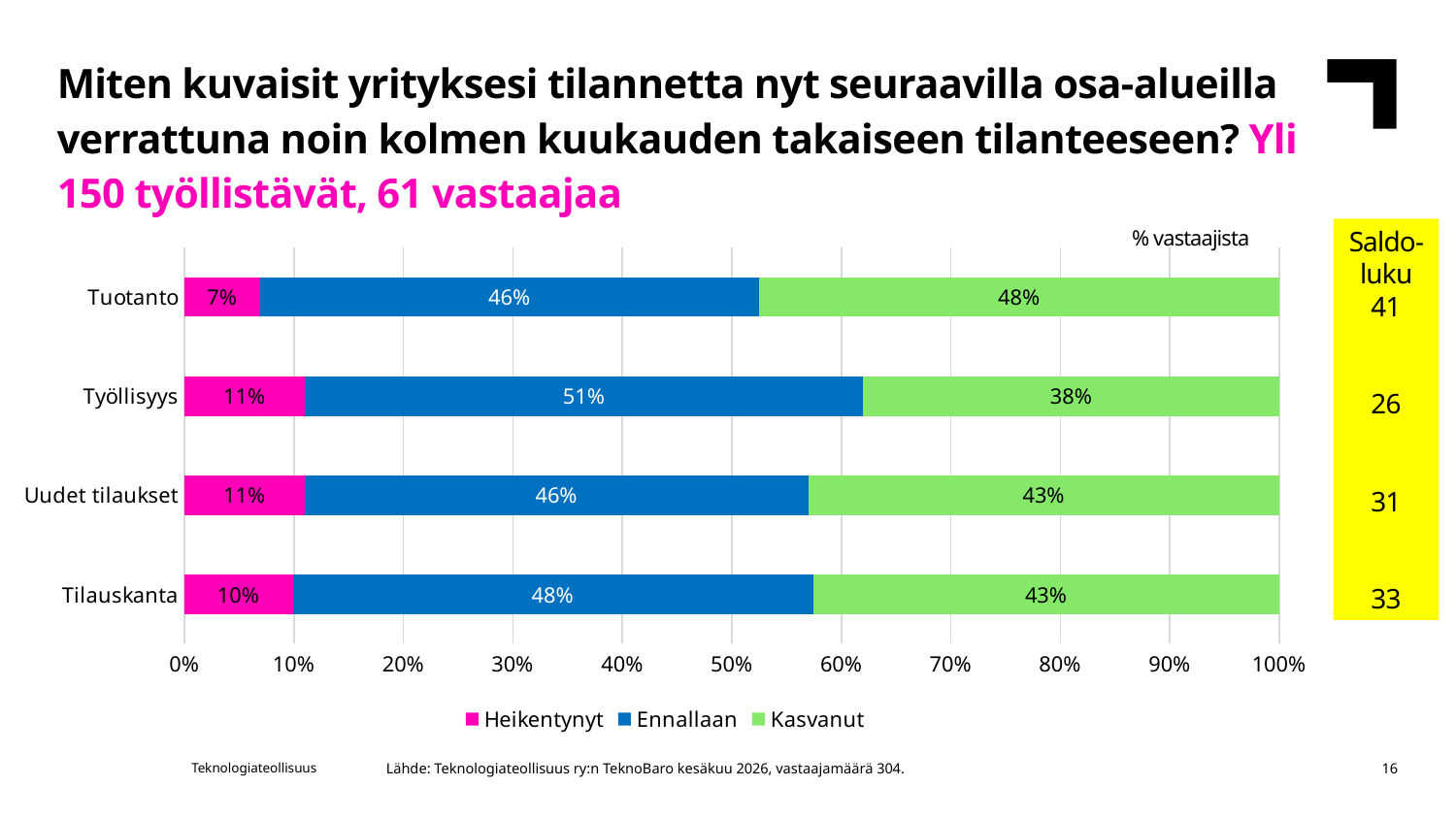
Which category has the highest "Kasvanut" share? Tuotanto How many categories are shown on the y axis of the chart? 4 What percentage of respondents answered "Kasvanut" for Tuotanto? 48% What is the "Ennallaan" value for Työllisyys? 51% Which category has the lowest "Heikentynyt" share? Tuotanto How many series does the legend list? 3 Which colour represents the "Heikentynyt" series in the legend? Magenta (pink) Is the "Ennallaan" value larger for Työllisyys or for Uudet tilaukset? Työllisyys What kind of chart is shown on the slide? Stacked bar chart What is the "Heikentynyt" value for Tilauskanta? 10% What is the difference between the "Kasvanut" values for Tuotanto and Työllisyys? 10 percentage points What is the Saldoluku value shown for Työllisyys? 26